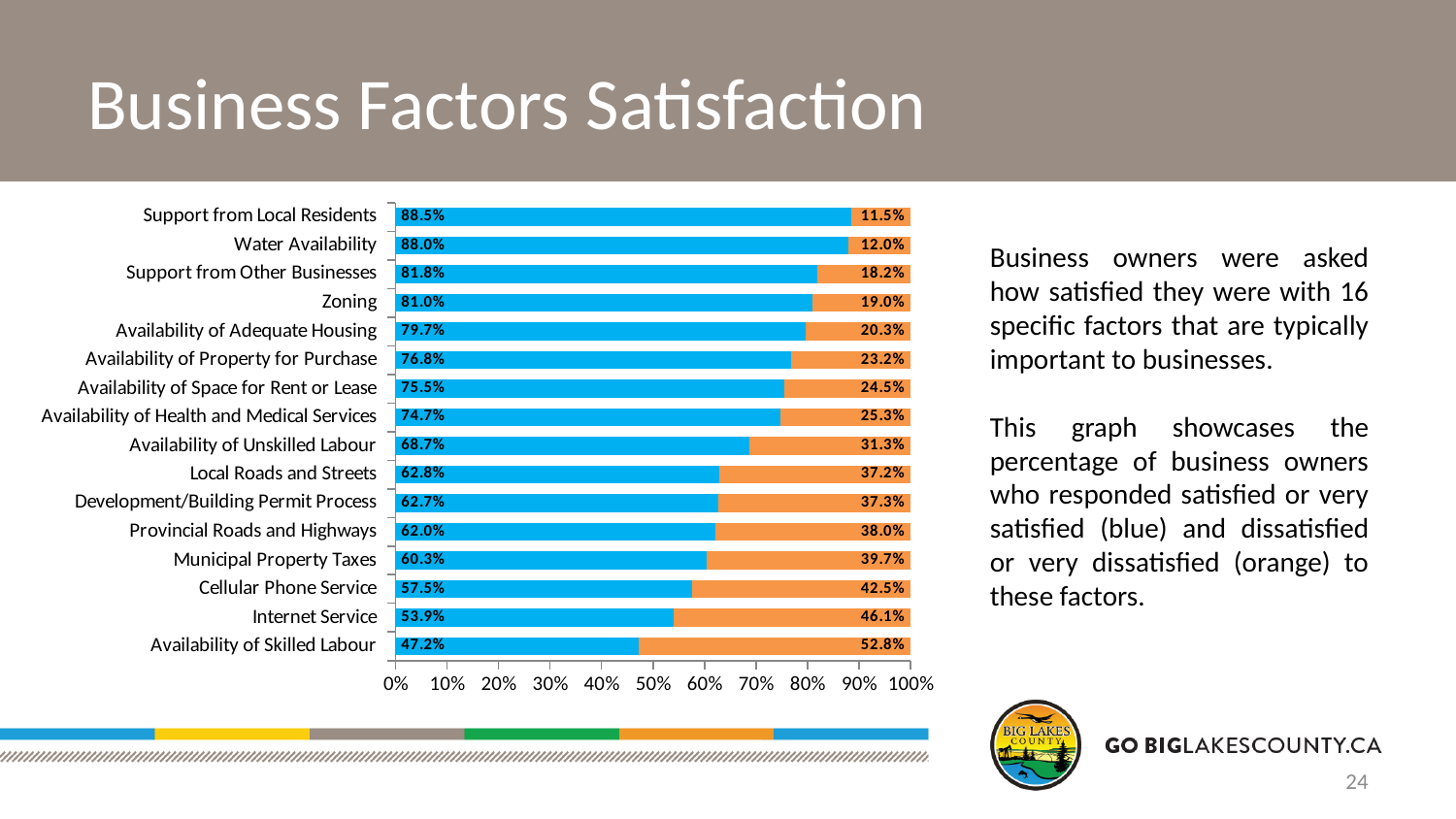
Which factor has the highest dissatisfied (orange) percentage? Availability of Skilled Labour How many business factors are shown in the chart? 16 Which has a higher satisfied percentage: Local Roads and Streets or Provincial Roads and Highways? Local Roads and Streets What type of chart is shown on the slide? Stacked bar chart What is the satisfied (blue) value for Municipal Property Taxes? 60.3% What is the difference between the satisfied percentages for Zoning and Internet Service? 27.1% What percentage of business owners were satisfied or very satisfied with Water Availability? 88.0% Which colour represents business owners who responded dissatisfied or very dissatisfied? Orange What is the dissatisfied (orange) value for Cellular Phone Service? 42.5% Which factor has the highest satisfied (blue) percentage? Support from Local Residents What is the total of the satisfied and dissatisfied values for Availability of Unskilled Labour? 100.0% Which factor has the lowest satisfied (blue) percentage? Availability of Skilled Labour